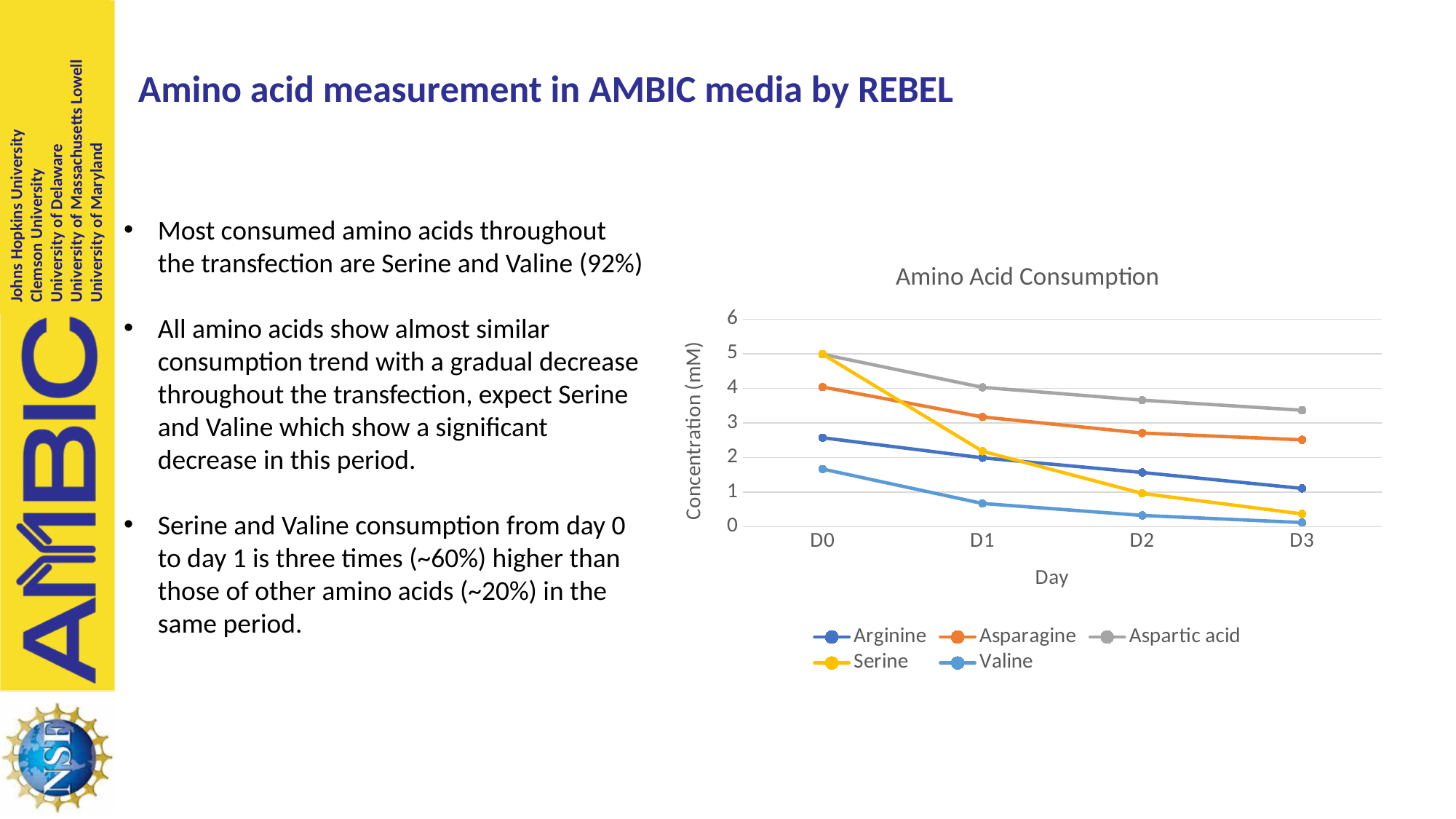
What is the title of the chart on the slide? Amino Acid Consumption Which amino acid has the highest concentration at D3? Aspartic acid At D2, which is larger: the concentration of Arginine or Serine? Arginine What is the y-axis label of the chart? Concentration (mM) What kind of chart is shown on the slide? line chart Is the Aspartic acid concentration at D3 greater or less than 3? greater How many series does the legend of the Amino Acid Consumption chart list? 5 Is the Valine concentration at D1 greater or less than 1? less Is the Asparagine concentration at D1 greater or less than 3? greater Which amino acid has the lowest concentration at D0? Valine How many days (x-axis categories) are plotted in the Amino Acid Consumption chart? 4 Does the Serine concentration rise or fall from D0 to D3? fall